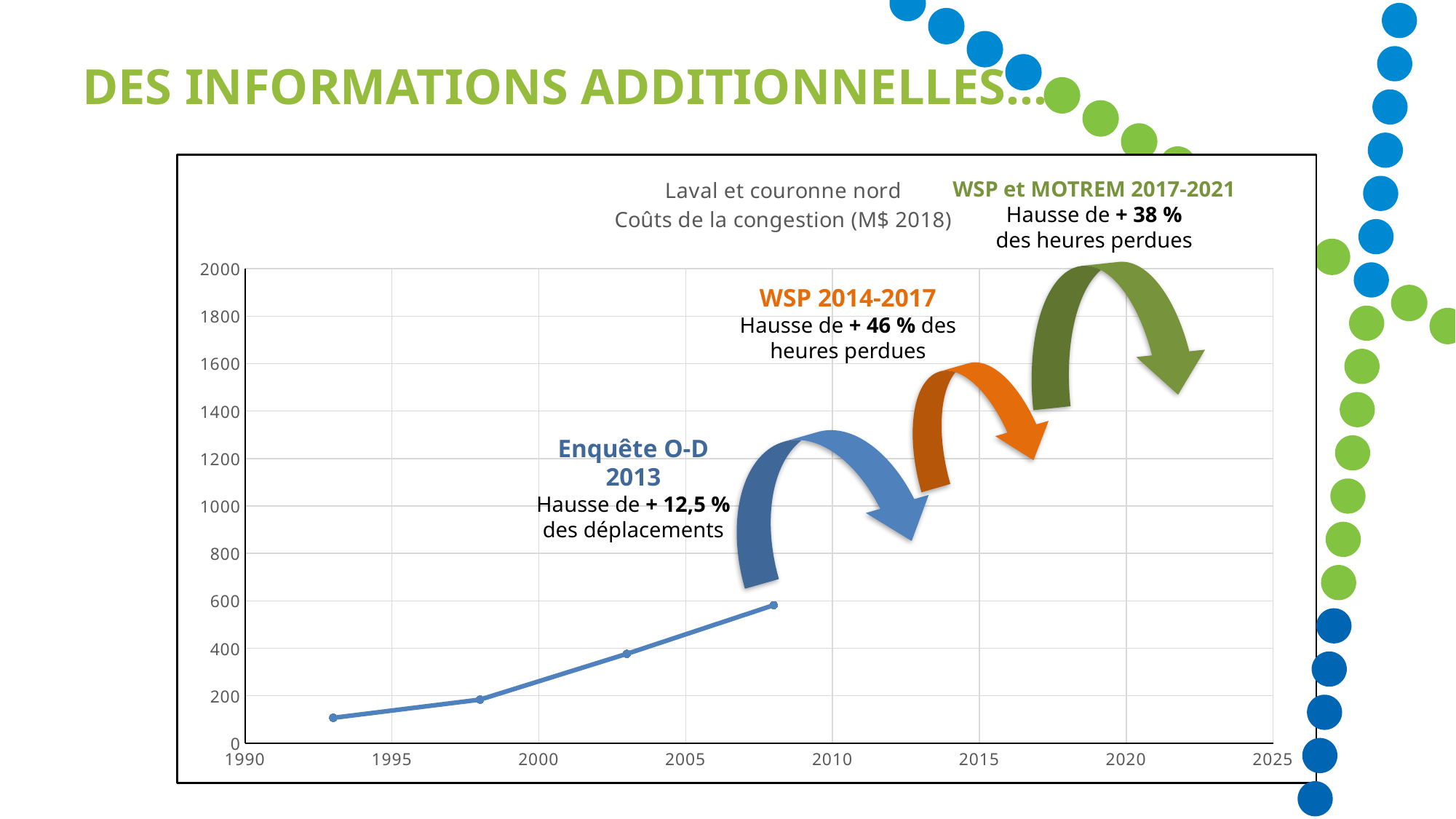
Is the value for 2003 greater or less than 200? greater According to the annotation for WSP 2014-2017, by what percentage did lost hours increase? + 46 % Is the value for 2008 greater or less than 400? greater Is the value for 1993 greater or less than 200? less Which year has the highest plotted congestion cost? 2008 What is the title of the chart? Laval et couronne nord Coûts de la congestion (M$ 2018) What kind of chart is shown on the slide? line chart Do the congestion cost values rise or fall from 1993 to 2008? rise Which year has the lowest plotted congestion cost? 1993 How many data points are plotted on the line? 4 Which is larger, the value for 2003 or the value for 1998? 2003